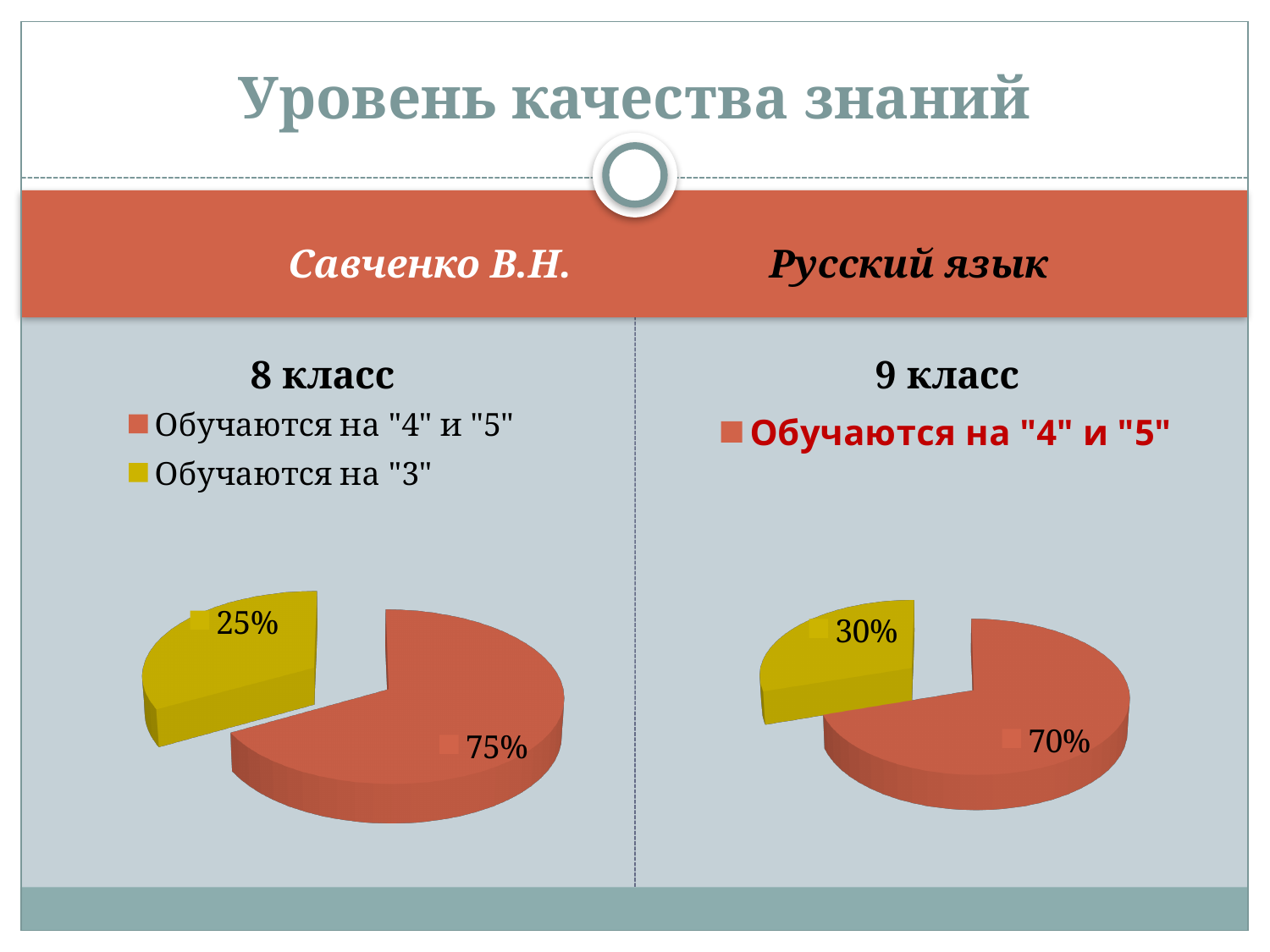
In the 8 класс chart on the left, which slice is the largest? Обучаются на "4" и "5" In the 9 класс chart on the right, what is the difference between the red slice (70%) and the yellow slice (30%)? 40% In the 8 класс chart on the left, what is the difference between the red slice (75%) and the yellow slice (25%)? 50% In the 8 класс chart on the left, what share of the pie is labelled for the yellow slice (Обучаются на "3")? 25% How many legend entries are shown for the 8 класс chart on the left? 2 In the 8 класс chart on the left, which slice is the smallest? Обучаются на "3" In the 9 класс chart on the right, what share of the pie is labelled for the red slice? 70% In the 9 класс chart on the right, what share of the pie is labelled for the yellow slice? 30% How many slices does the 8 класс pie chart on the left have? 2 What kind of chart is used for the 8 класс data on the left? pie chart Which is larger: the red slice in the 8 класс chart on the left or the red slice in the 9 класс chart on the right? the 8 класс chart (75%)